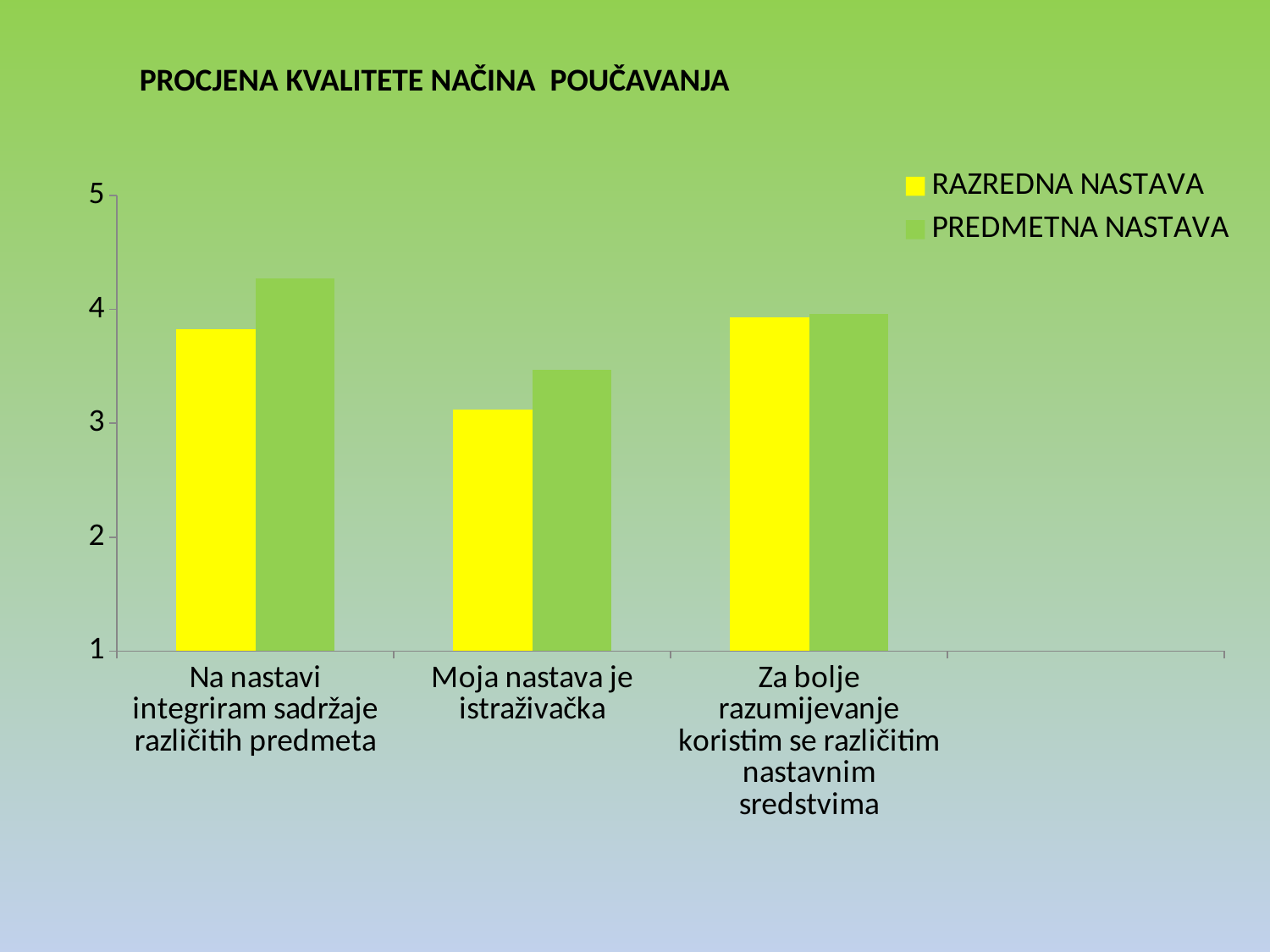
What kind of chart is shown on the slide? bar chart For "Na nastavi integriram sadržaje različitih predmeta", which series has the larger value, RAZREDNA NASTAVA or PREDMETNA NASTAVA? PREDMETNA NASTAVA For "Moja nastava je istraživačka", which series has the larger value, RAZREDNA NASTAVA or PREDMETNA NASTAVA? PREDMETNA NASTAVA How many series does the legend list? 2 Which series is shown in yellow? RAZREDNA NASTAVA Is the PREDMETNA NASTAVA value for "Na nastavi integriram sadržaje različitih predmeta" greater or less than 4? greater What is the title of the chart? PROCJENA KVALITETE NAČINA POUČAVANJA How many categories are shown on the x axis? 3 Is the RAZREDNA NASTAVA value for "Moja nastava je istraživačka" greater or less than 4? less Which category has the lowest RAZREDNA NASTAVA value? Moja nastava je istraživačka Is the RAZREDNA NASTAVA value for "Na nastavi integriram sadržaje različitih predmeta" greater or less than 3? greater